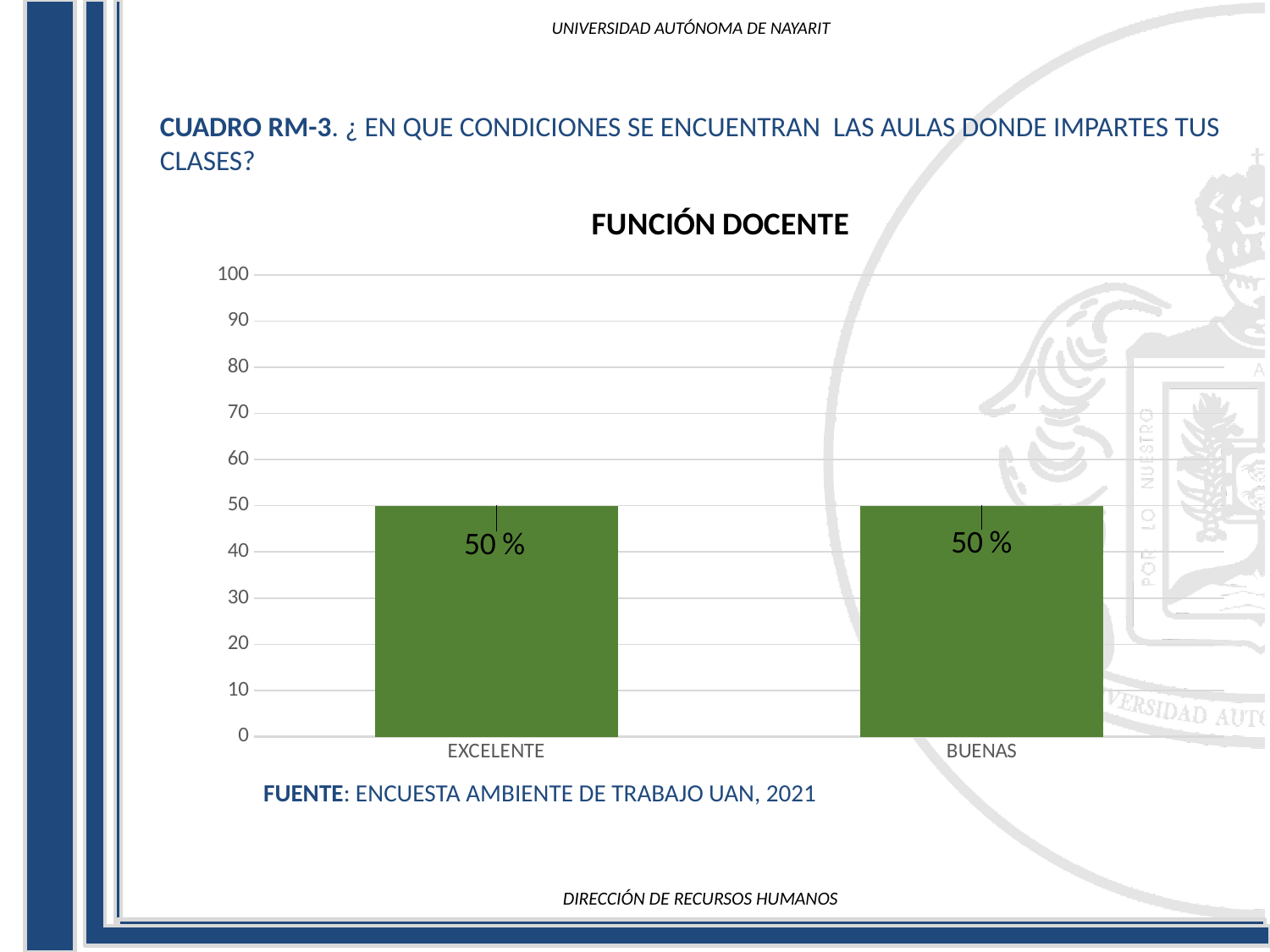
What kind of chart is shown? bar chart What is the highest value shown on the y axis? 100 Is the value for BUENAS greater or less than 40? greater What is the title of the chart? FUNCIÓN DOCENTE What colour are the bars in the chart? green What is the value for BUENAS? 50 % What is the value for EXCELENTE? 50 % What is the difference between the values for EXCELENTE and BUENAS? 0 How many categories are shown on the x axis? 2 What is the total of the values for EXCELENTE and BUENAS? 100 % Is the value for EXCELENTE greater or less than 60? less